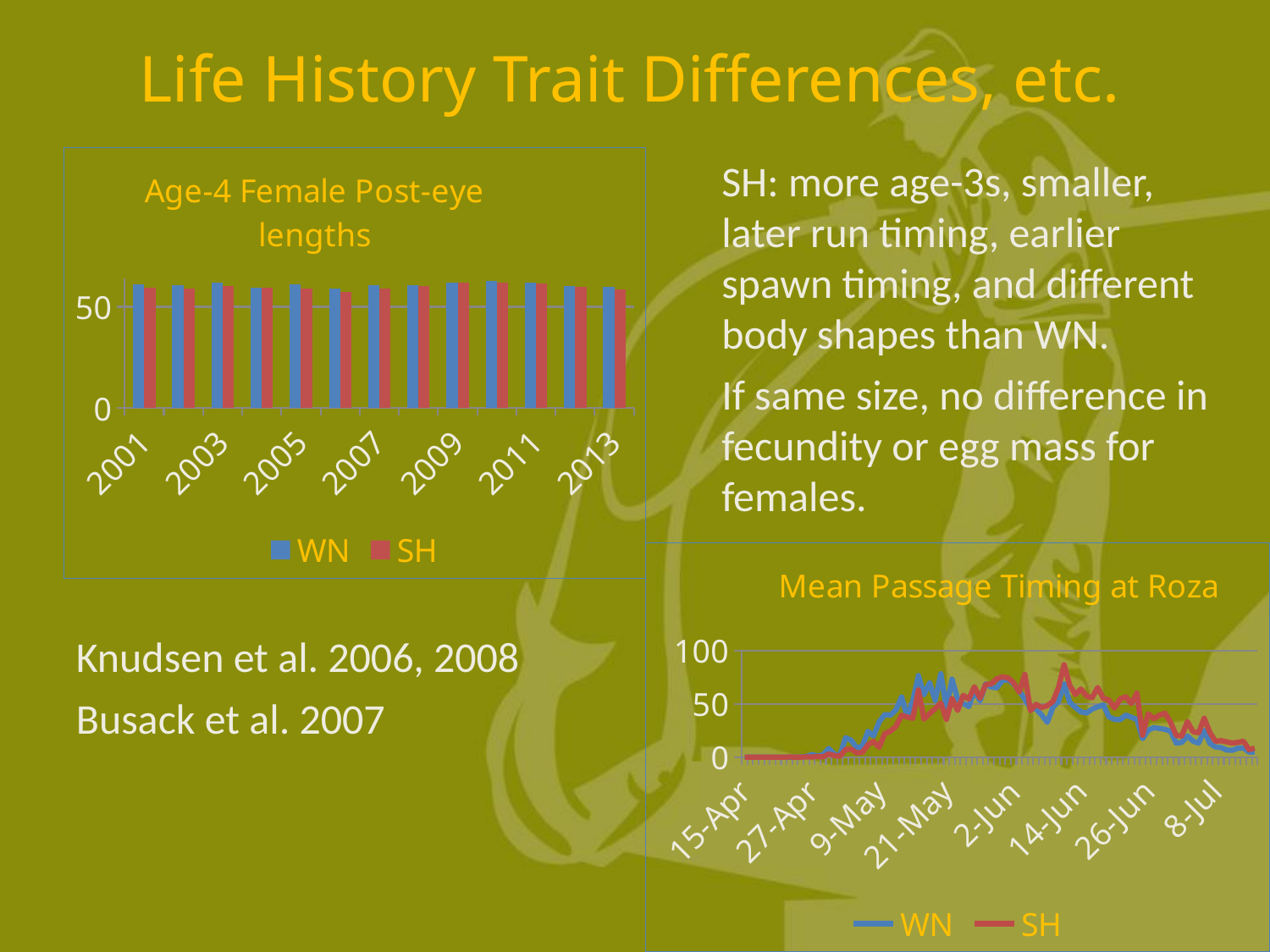
How many series does the legend of the 'Age-4 Female Post-eye lengths' chart list? 2 In the 'Age-4 Female Post-eye lengths' chart, what is the first year shown on the x axis? 2001 Which series are listed in the legend of the 'Mean Passage Timing at Roza' chart? WN and SH In the 'Mean Passage Timing at Roza' chart, is the WN value at 15-Apr greater or less than 50? less What kind of chart is the 'Mean Passage Timing at Roza' chart? line chart In the 'Age-4 Female Post-eye lengths' chart, is the WN value for 2001 greater or less than 50? greater In the 'Mean Passage Timing at Roza' chart, do the values rise or fall from 27-Apr to 21-May? rise In the 'Mean Passage Timing at Roza' chart, do the values rise or fall from 26-Jun to 8-Jul? fall In the 'Age-4 Female Post-eye lengths' chart, is the SH value for 2013 greater or less than 50? greater What kind of chart is the 'Age-4 Female Post-eye lengths' chart? bar chart In the 'Mean Passage Timing at Roza' chart, what is the highest value shown on the y axis? 100